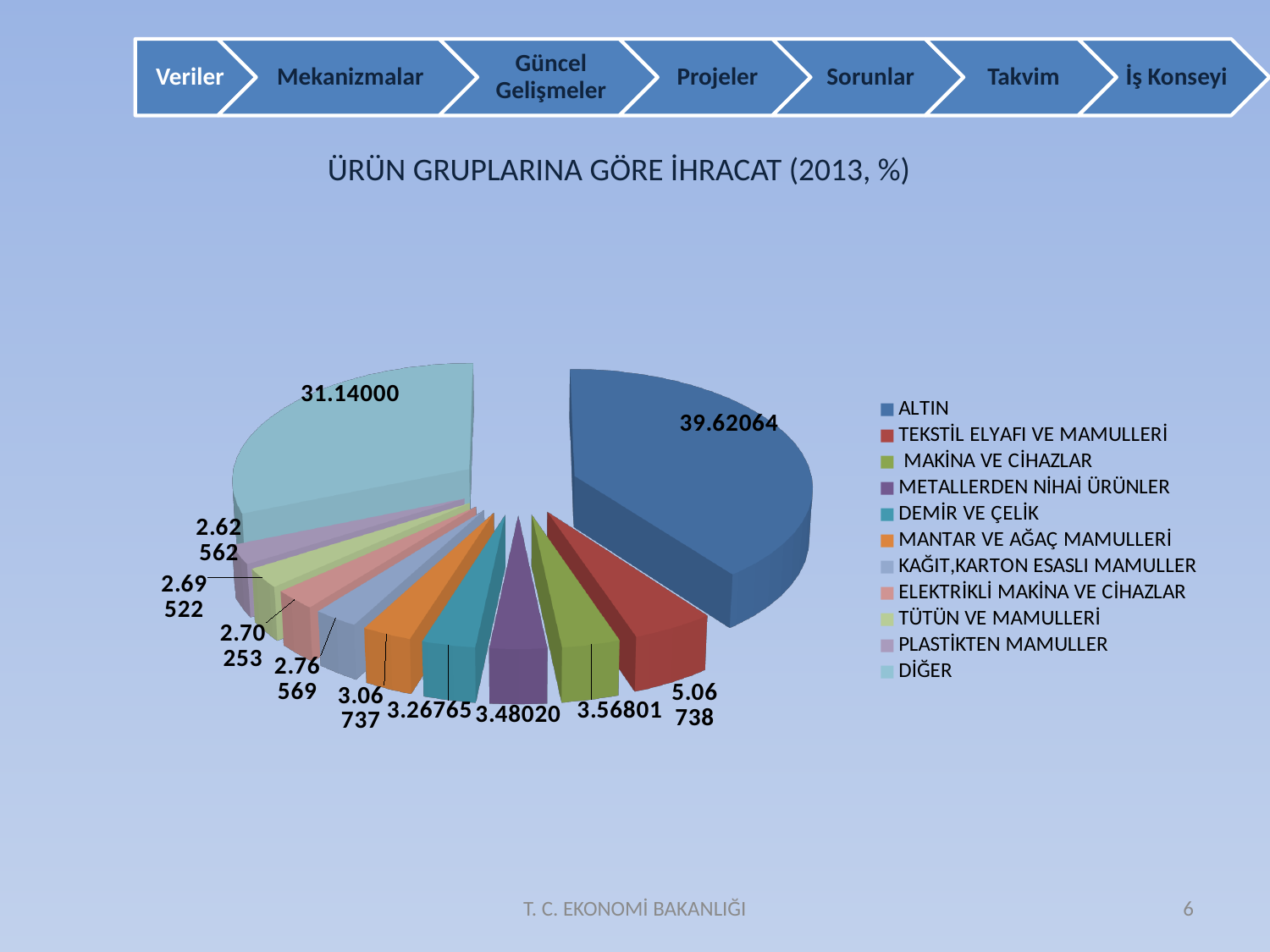
What is the difference between the values for ALTIN and DİĞER? 8.48064 What type of chart is shown on the slide? Pie chart Which category has the largest share of the pie? ALTIN What is the value shown for DİĞER? 31.14000 How many categories are shown in the pie chart? 11 What is the value shown for MAKİNA VE CİHAZLAR? 3.56801 What is the value shown for ALTIN? 39.62064 Which category has the smallest share of the pie? PLASTİKTEN MAMULLER What is the title of the chart? ÜRÜN GRUPLARINA GÖRE İHRACAT (2013, %) What is the value shown for TEKSTİL ELYAFI VE MAMULLERİ? 5.06738 Which is larger, the value for TEKSTİL ELYAFI VE MAMULLERİ or the value for MAKİNA VE CİHAZLAR? TEKSTİL ELYAFI VE MAMULLERİ What is the value shown for DEMİR VE ÇELİK? 3.26765